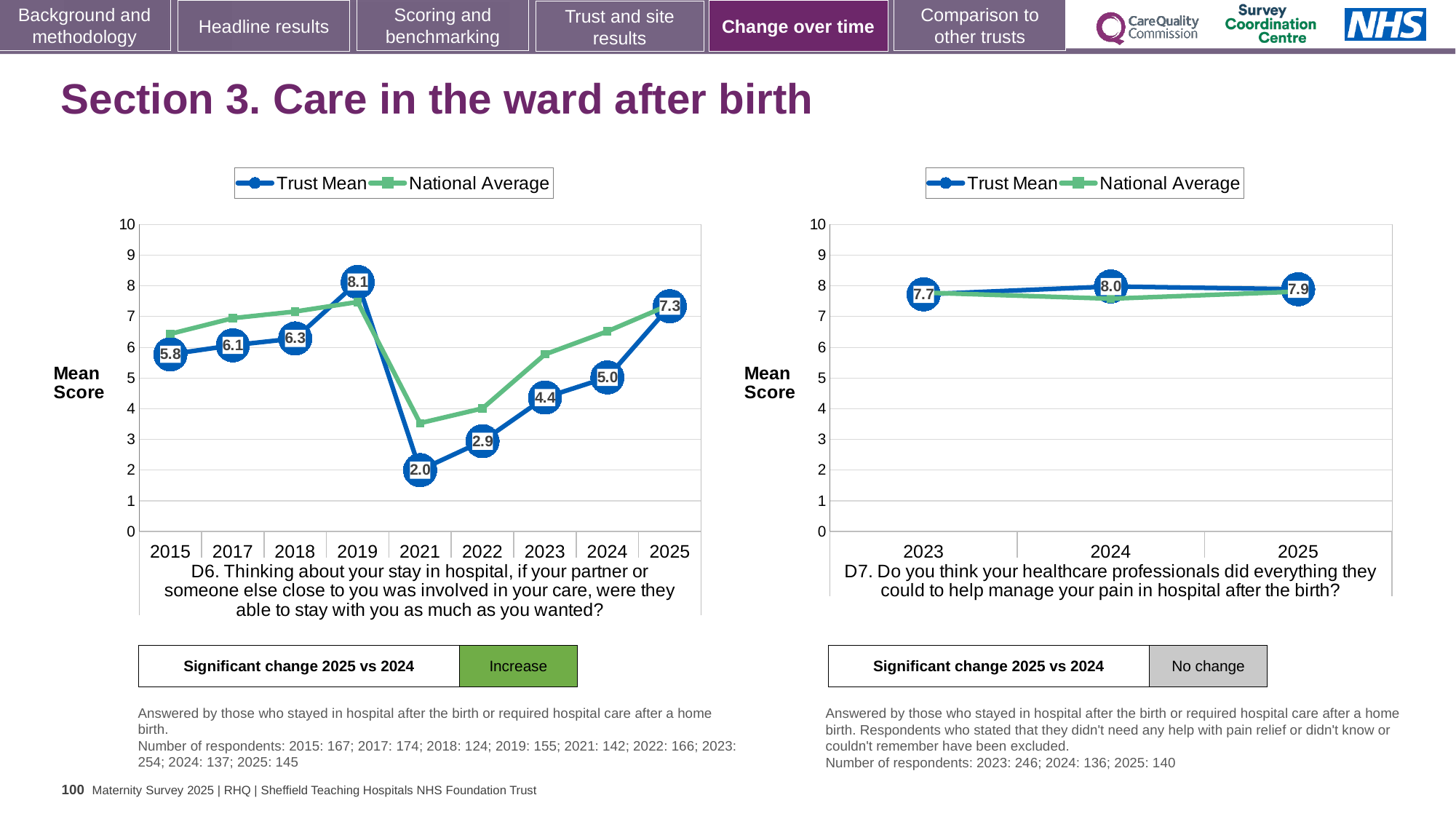
In the D7 chart on the right, is the Trust Mean score for 2025 larger or smaller than for 2023? larger In the D6 chart on the left, is the National Average for 2021 greater or less than 4? less In the D6 chart on the left, which year has the highest Trust Mean score? 2019 In the D7 chart on the right, what is the Trust Mean score for 2024? 8.0 In the D6 chart on the left, how many years are shown on the x axis? 9 In the D6 chart on the left, what is the Trust Mean score for 2021? 2.0 In the D6 chart on the left, what is the Trust Mean score for 2019? 8.1 In the D7 chart on the right, which year has the lowest Trust Mean score? 2023 What type of chart is the D6 chart on the left? Line chart In the D6 chart on the left, what is the difference between the Trust Mean scores for 2025 and 2024? 2.3 How many series does the legend of the D7 chart on the right list? 2 In the D6 chart on the left, which year has the lowest Trust Mean score? 2021